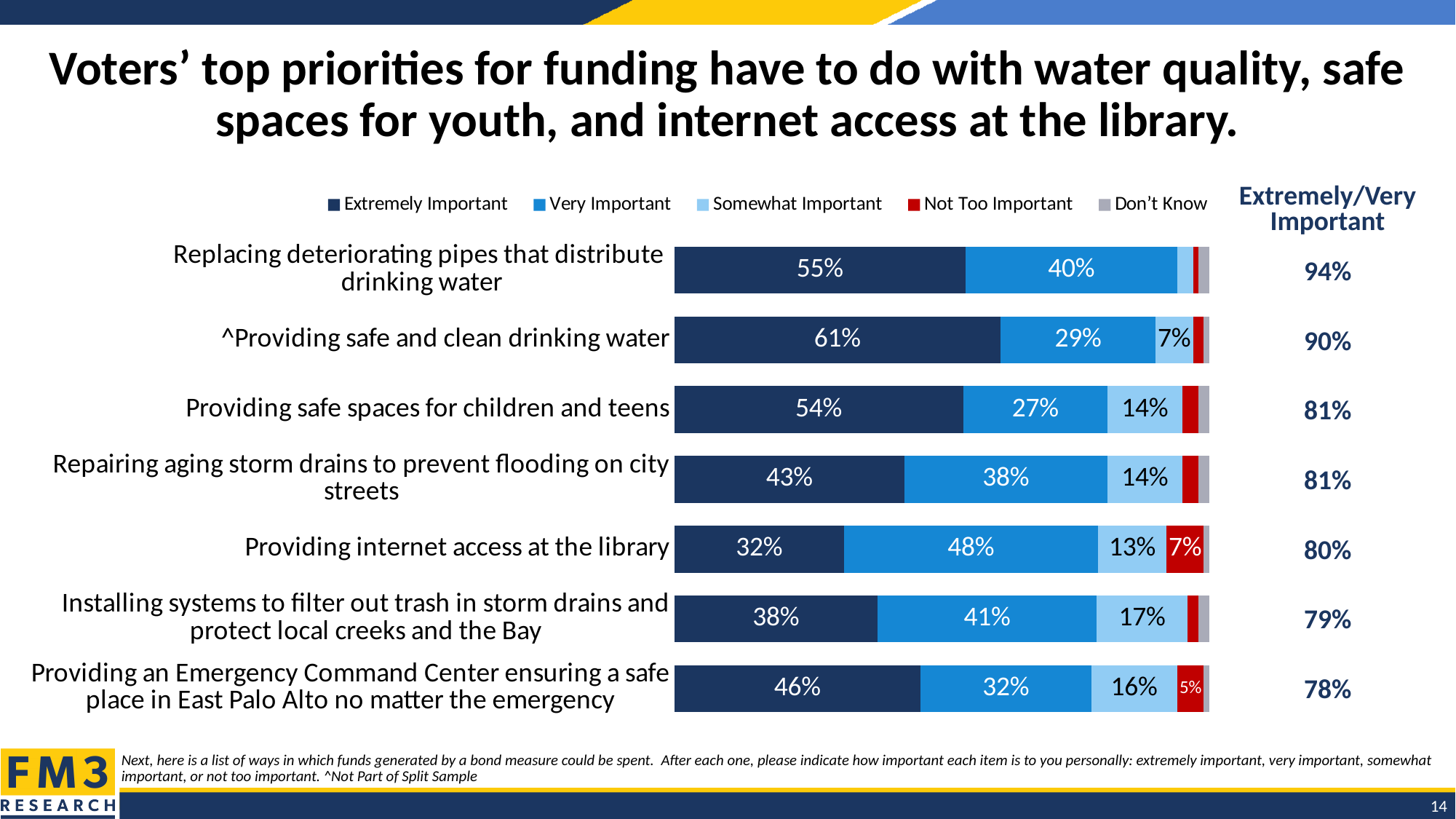
What percentage of voters rated "Providing safe and clean drinking water" as Extremely Important? 61% What is the combined Extremely/Very Important percentage for "Providing an Emergency Command Center ensuring a safe place in East Palo Alto no matter the emergency"? 78% What percentage of voters rated "Providing internet access at the library" as Very Important? 48% What kind of chart is shown on the slide? Stacked bar chart How many series does the legend list? 5 How many funding items are shown in the chart? 7 Which has a larger Very Important share: "Providing internet access at the library" or "Replacing deteriorating pipes that distribute drinking water"? Providing internet access at the library What is the Not Too Important percentage for "Providing internet access at the library"? 7% How many percentage points higher is the Extremely Important share for "Replacing deteriorating pipes that distribute drinking water" than for "Repairing aging storm drains to prevent flooding on city streets"? 12 percentage points Which item has the lowest Extremely Important percentage? Providing internet access at the library Which item has the highest Extremely Important percentage? Providing safe and clean drinking water What is the Somewhat Important percentage for "Installing systems to filter out trash in storm drains and protect local creeks and the Bay"? 17%